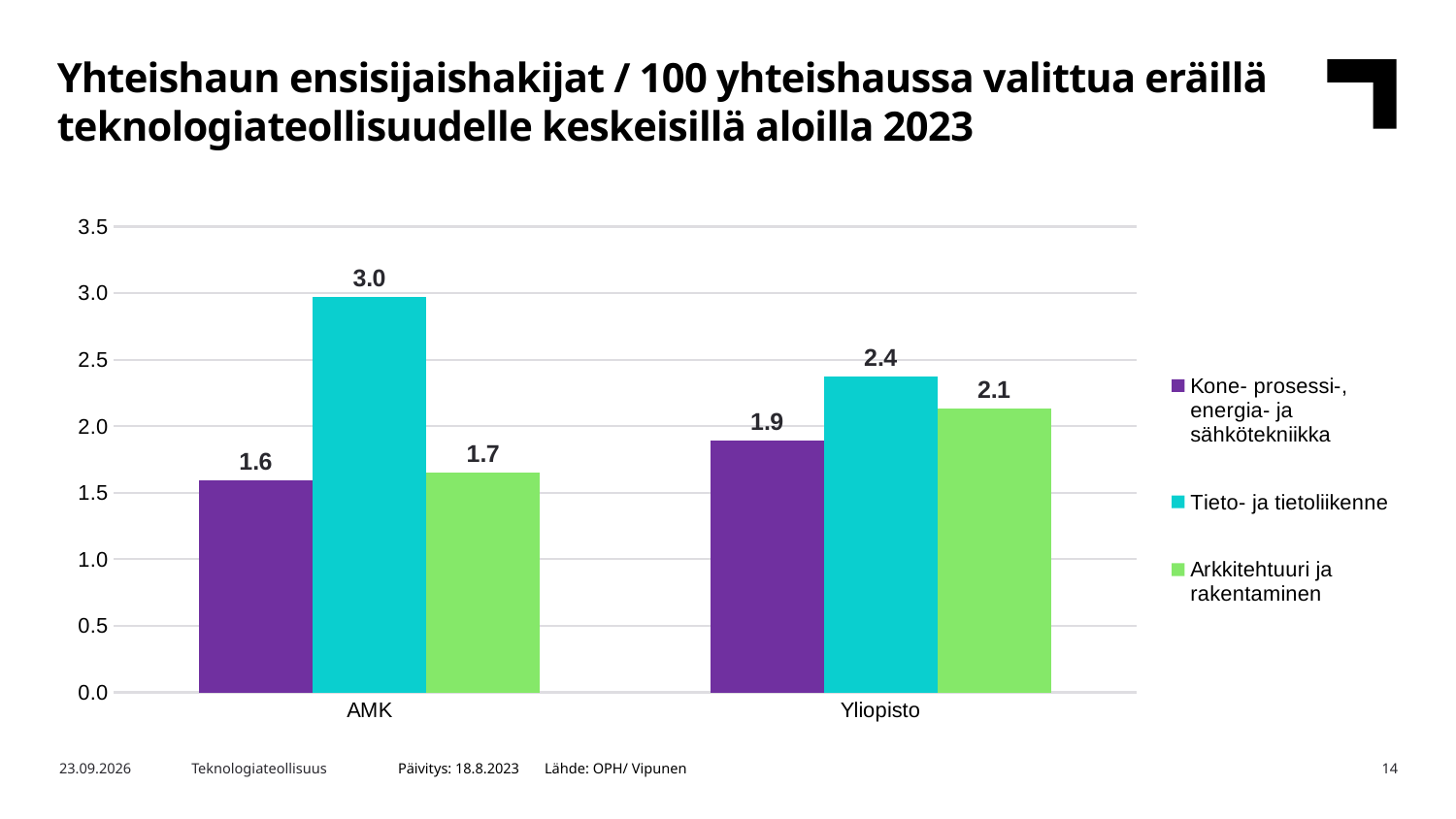
Which is larger: the Kone- prosessi-, energia- ja sähkötekniikka value for AMK or for Yliopisto? Yliopisto How many categories are shown on the x axis? 2 How many series does the legend list? 3 What is the difference between the Tieto- ja tietoliikenne values for AMK and Yliopisto? 0.6 What is the value for Arkkitehtuuri ja rakentaminen in the AMK category? 1.7 What is the value for Kone- prosessi-, energia- ja sähkötekniikka in the Yliopisto category? 1.9 What is the value for Tieto- ja tietoliikenne in the AMK category? 3.0 What is the value for Arkkitehtuuri ja rakentaminen in the Yliopisto category? 2.1 Which series has the lowest value in the Yliopisto category? Kone- prosessi-, energia- ja sähkötekniikka Is the value for Tieto- ja tietoliikenne in the Yliopisto category greater or less than 2.0? greater What kind of chart is shown on the slide? Bar chart Which series has the highest value in the AMK category? Tieto- ja tietoliikenne